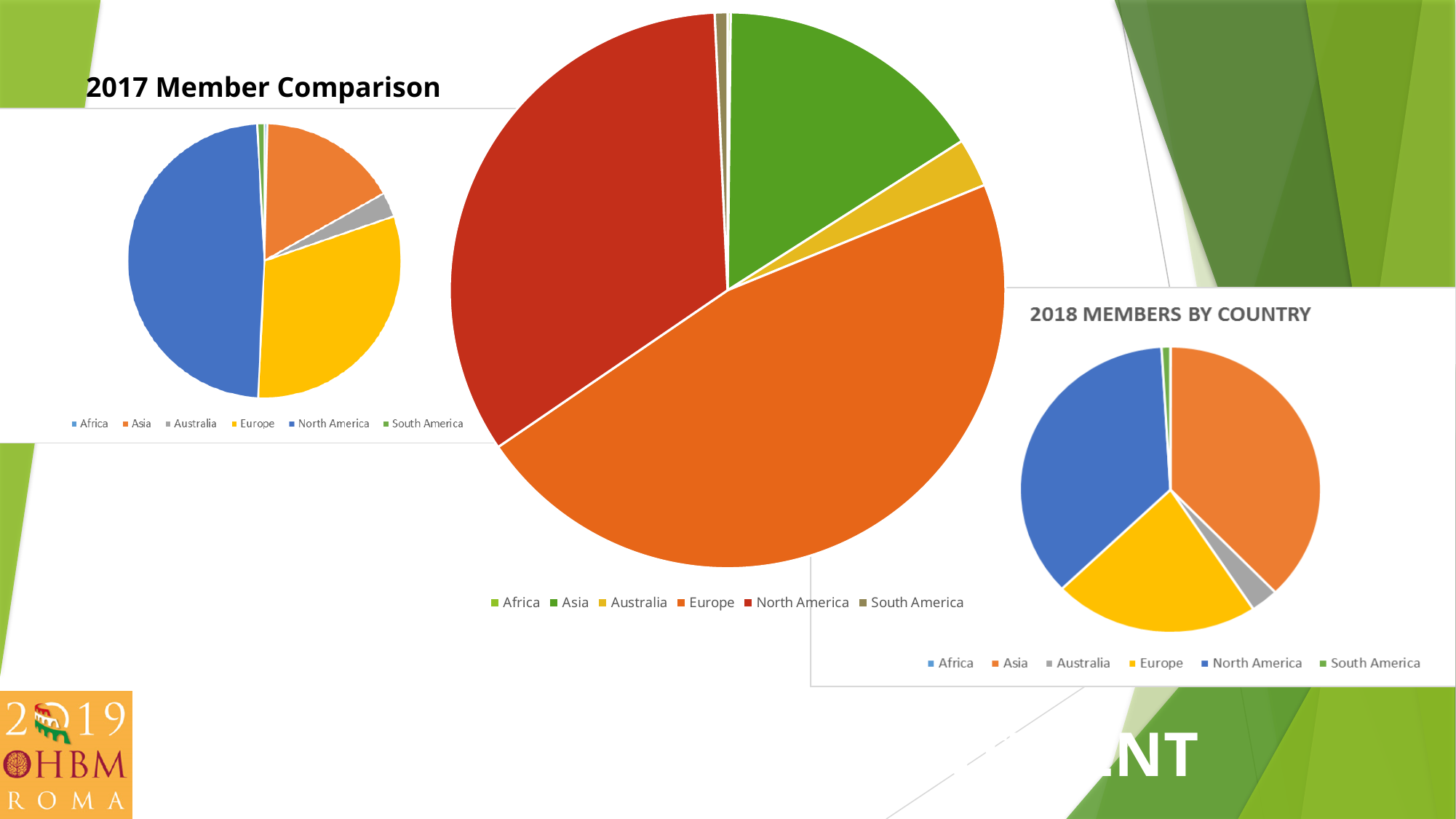
In the large central pie chart, which slice is larger, North America or Asia? North America What is the title of the pie chart on the right side of the slide? 2018 MEMBERS BY COUNTRY In the large central pie chart, which region has the largest slice? Europe How many categories does the legend of the "2018 MEMBERS BY COUNTRY" chart list? 6 What kind of chart is the "2017 Member Comparison" chart? pie chart In the "2018 MEMBERS BY COUNTRY" chart, which slice is larger, Europe or Australia? Europe In the "2017 Member Comparison" chart, which slice is larger, Europe or Asia? Europe How many categories does the legend of the "2017 Member Comparison" chart list? 6 In the "2017 Member Comparison" chart, which region has the largest slice? North America What colour represents Europe in the "2018 MEMBERS BY COUNTRY" chart? yellow What kind of chart is the "2018 MEMBERS BY COUNTRY" chart? pie chart